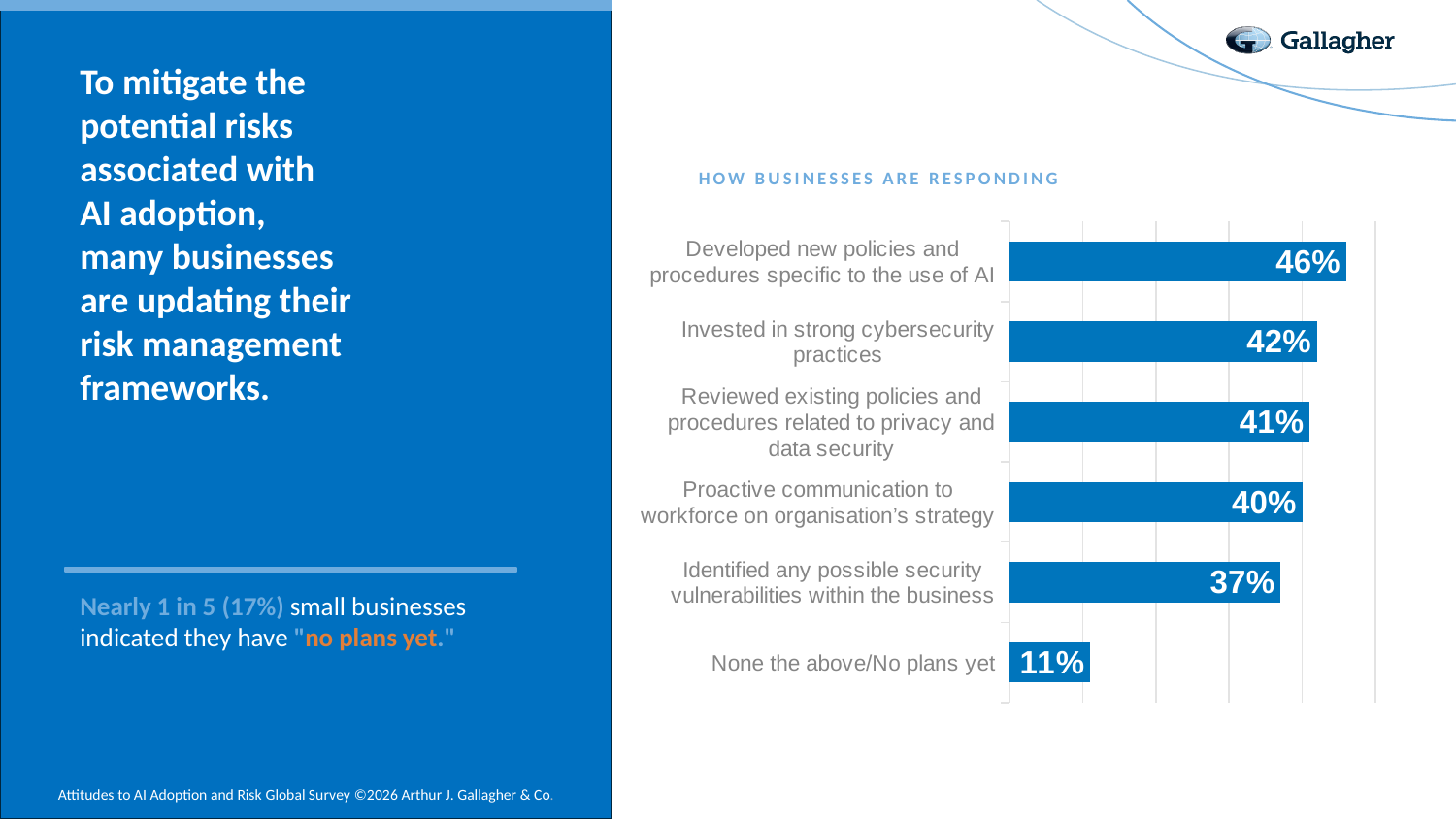
What is the title of the chart? HOW BUSINESSES ARE RESPONDING Which category has the highest value in the chart? Developed new policies and procedures specific to the use of AI What is the difference between 'Invested in strong cybersecurity practices' and 'Identified any possible security vulnerabilities within the business'? 5% What is the value for 'Invested in strong cybersecurity practices'? 42% What is the difference between the values for 'Developed new policies and procedures specific to the use of AI' and 'None the above/No plans yet'? 35% What percentage of businesses identified any possible security vulnerabilities within the business? 37% Which category has the lowest value in the chart? None the above/No plans yet Which is larger: the value for 'Proactive communication to workforce on organisation's strategy' or 'Identified any possible security vulnerabilities within the business'? Proactive communication to workforce on organisation's strategy How many categories are shown in the chart? 6 What kind of chart is shown on the slide? Bar chart What percentage of businesses developed new policies and procedures specific to the use of AI? 46% What is the value for 'None the above/No plans yet'? 11%